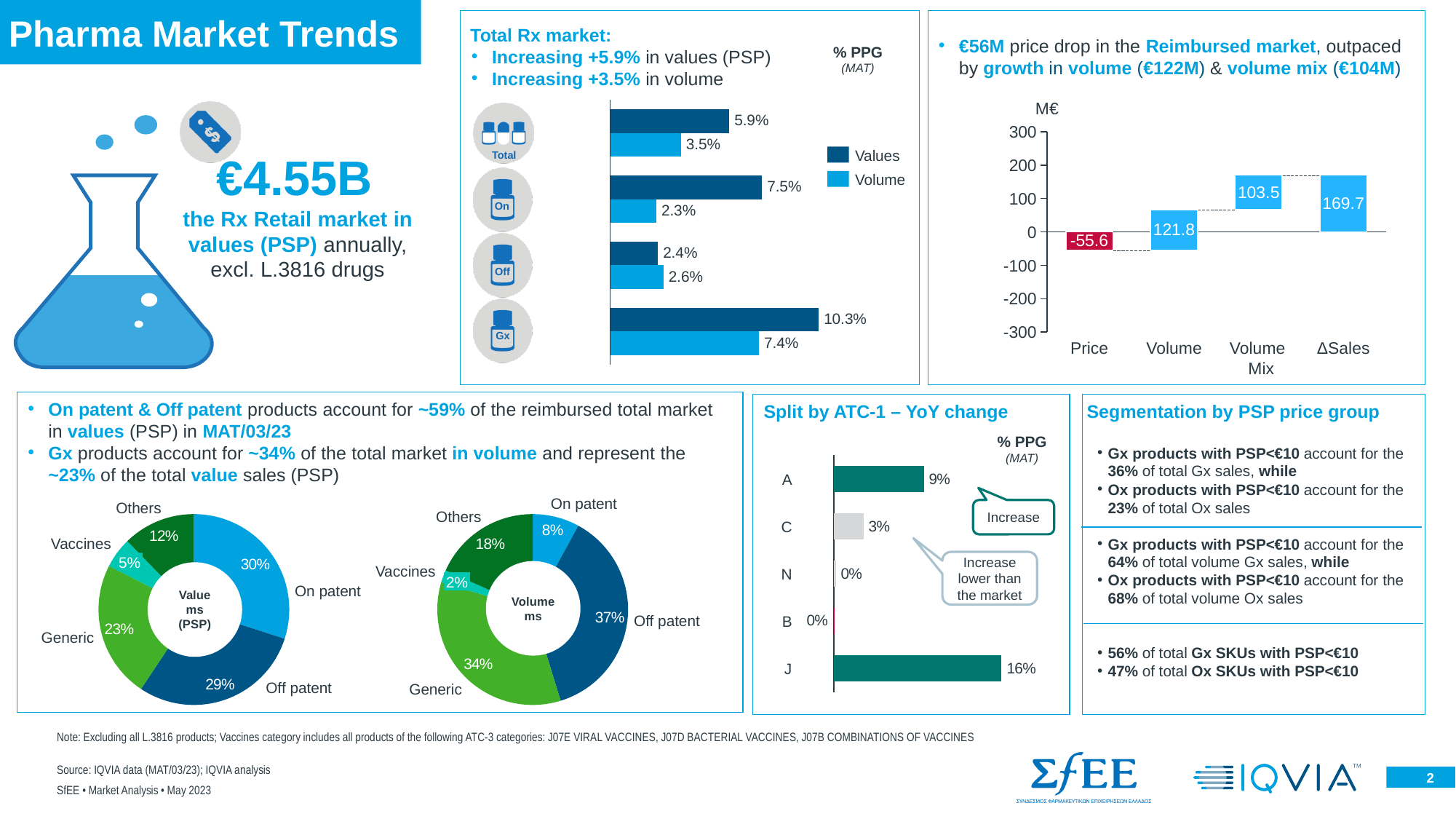
In the Total Rx market % PPG bar chart, what is the Volume growth for On patent? 2.3% In the Volume ms donut chart, which is larger, the share of Others or the share of On patent? Others In the Split by ATC-1 – YoY change bar chart, what is the % PPG for J? 16% In the Total Rx market % PPG bar chart, what is the difference between the Values and Volume growth for On patent? 5.2% In the Volume ms donut chart, which category has the largest share? Off patent In the M€ waterfall chart of the Reimbursed market, what is the value for Volume Mix? 103.5 In the M€ waterfall chart of the Reimbursed market, is the value for Volume greater or less than 100? greater How many series does the legend of the Total Rx market % PPG bar chart list? 2 In the Total Rx market % PPG bar chart, what is the Values growth for Gx? 10.3% In the Total Rx market % PPG bar chart, which category has the highest Values growth? Gx In the Value ms (PSP) donut chart, what share does Generic have? 23% In the M€ waterfall chart of the Reimbursed market, what is the value for Price? -55.6